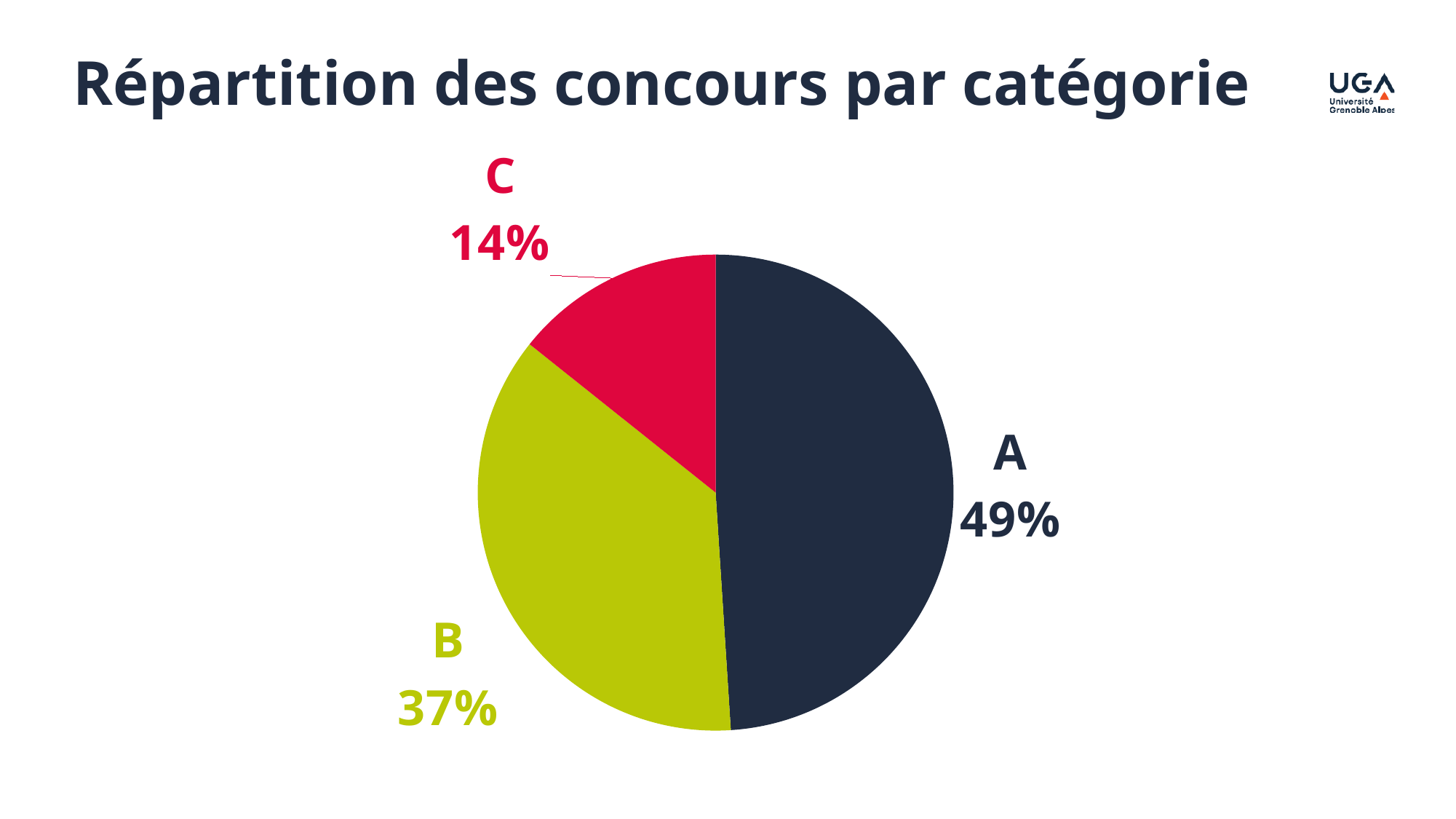
What is the difference in percentage points between category B and category C? 23 What kind of chart is shown on the slide? Pie chart What share of the pie does category C represent? 14% What is the title of the chart? Répartition des concours par catégorie Which category has the smallest share of the pie? C What share of the pie does category A represent? 49% Which is larger, the share for category B or the share for category C? B What colour is the slice for category B? Green What share of the pie does category B represent? 37% What is the difference in percentage points between category A and category B? 12 How many categories are shown in the pie chart? 3 Which category has the largest share of the pie? A